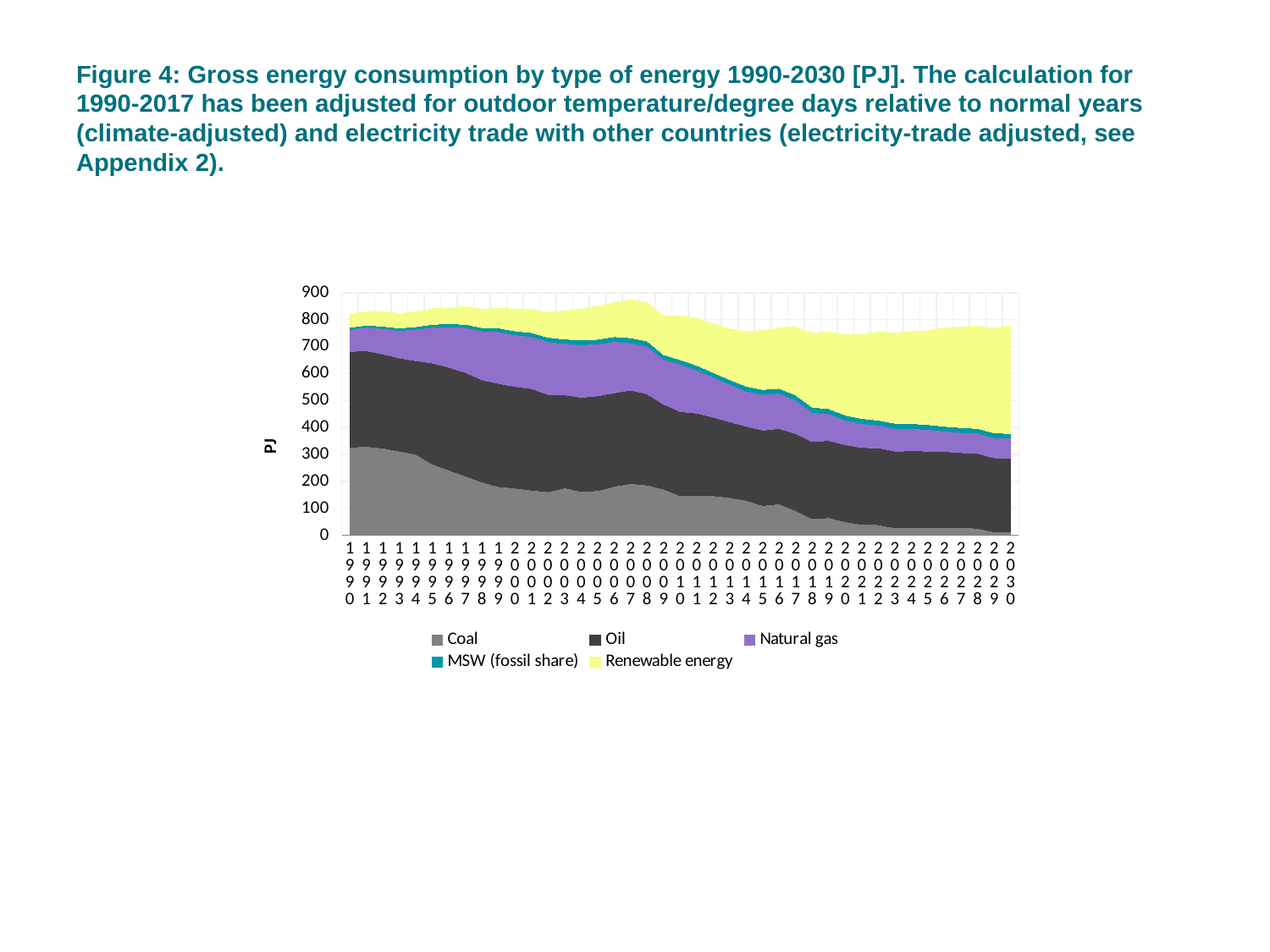
Does the Coal area rise or fall from 1990 to 2030? Fall Is the total gross energy consumption in 2030 greater or less than 800? less What is the label on the y axis? PJ Is the total gross energy consumption in 1990 greater or less than 800? greater How many series does the legend list? 5 What kind of chart is shown on the slide? Stacked area chart How many years are plotted along the x axis? 41 Is the value for Coal in 1990 greater or less than 300? greater In 1990, which is larger: Coal or Renewable energy? Coal Which series is shown in yellow in the legend? Renewable energy Which series accounts for the largest share of consumption in 2030? Renewable energy